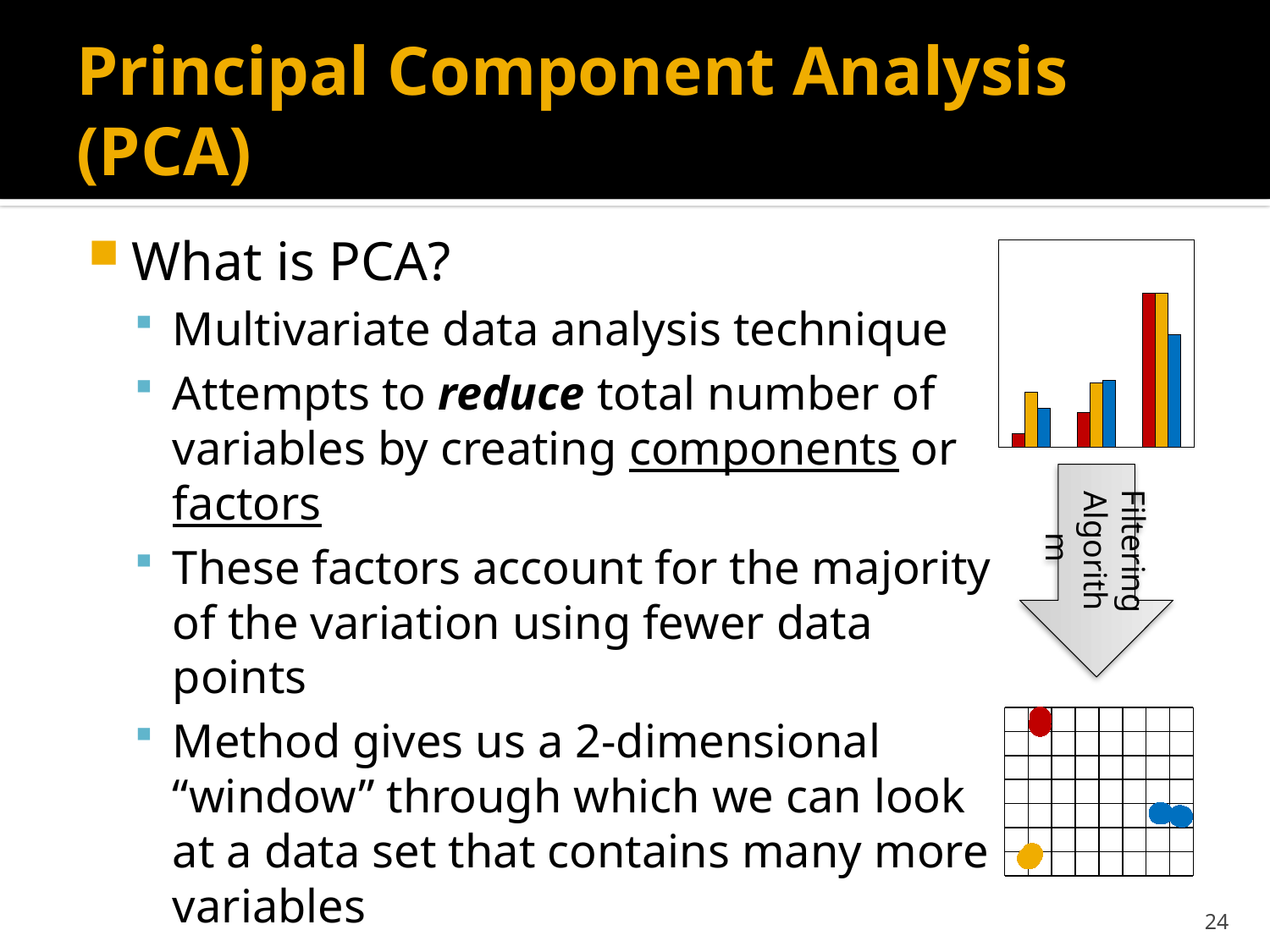
In the middle group of the top-right bar chart, which coloured bar is the shortest? red How many bars are in each group of the top-right bar chart? 3 In the leftmost group of the top-right bar chart, which coloured bar is the shortest? red In the top-right bar chart, which group of bars is the tallest: the left, middle, or right group? right What kind of chart is the chart in the top-right corner of the slide? bar chart How many bars in total are plotted in the top-right bar chart? 9 How many groups of bars does the top-right bar chart show? 3 What three colours are used for the bars in the top-right bar chart? red, yellow and blue What is the text on the arrow between the two charts on the right side of the slide? Filtering Algorithm In the leftmost group of the top-right bar chart, which coloured bar is the tallest? yellow In the rightmost group of the top-right bar chart, which coloured bar is the shortest? blue